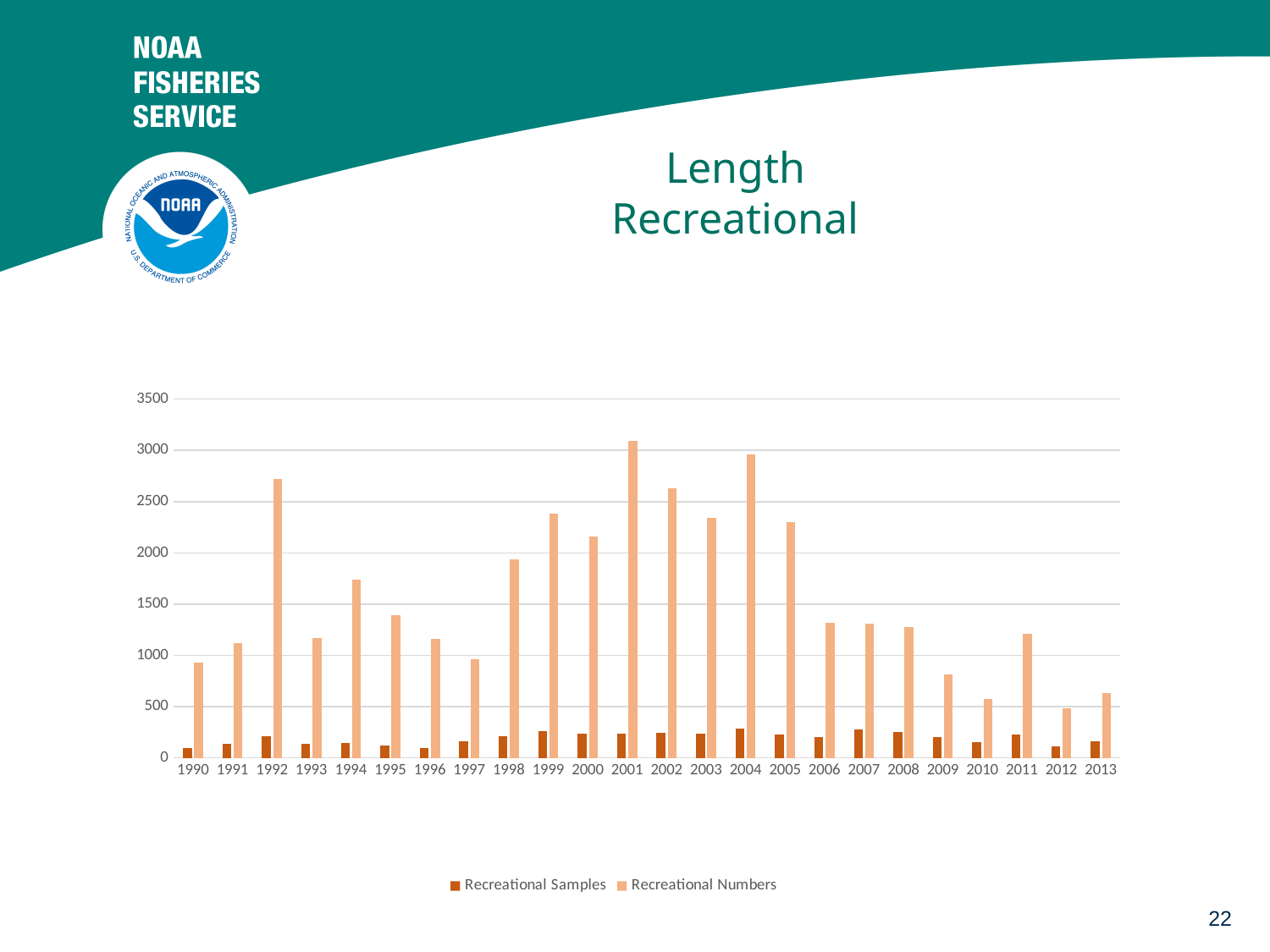
How many series does the legend list? 2 What kind of chart is shown on the slide? bar chart Which year has the highest value for Recreational Numbers? 2001 Which year has the larger Recreational Numbers value, 2001 or 2004? 2001 Is the Recreational Numbers value for 2009 greater or less than 1000? less Is the Recreational Numbers value for 1992 greater or less than 2500? greater Is the Recreational Samples value for 2004 greater or less than 500? less Which year has the larger Recreational Numbers value, 1992 or 1993? 1992 Do the Recreational Numbers values generally rise or fall from 2005 to 2013? fall How many years are shown on the x axis? 24